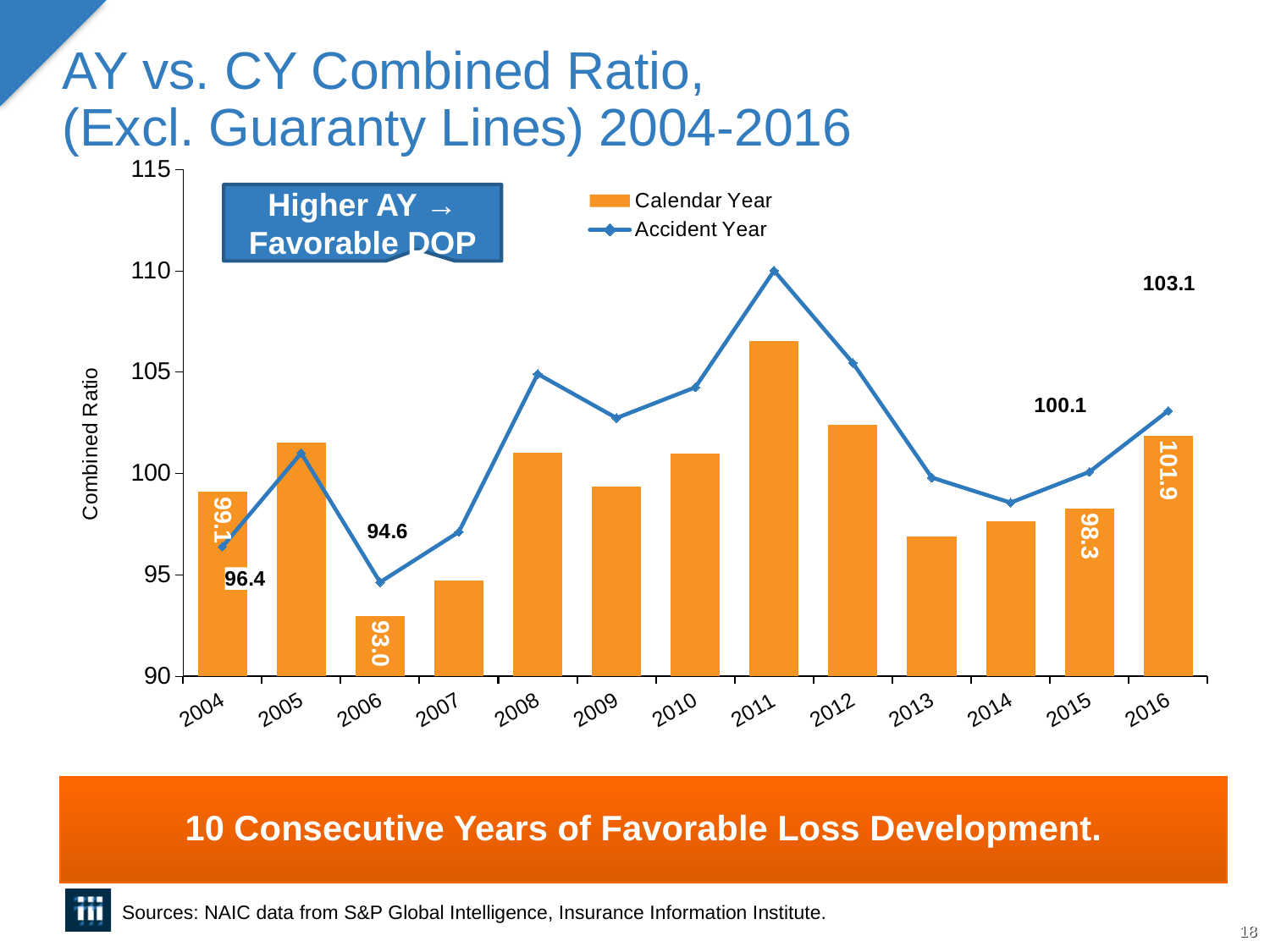
What is the Calendar Year combined ratio for 2004? 99.1 How many series does the legend list? 2 What is the Accident Year combined ratio for 2016? 103.1 How many years are shown on the x axis? 13 What is the Calendar Year combined ratio for 2006? 93.0 Is the Accident Year combined ratio for 2011 greater or less than 105? greater What is the difference between the Accident Year and Calendar Year combined ratios in 2016? 1.2 In which year is the Calendar Year combined ratio lowest? 2006 In which year is the Accident Year combined ratio highest? 2011 What is the Accident Year combined ratio for 2015? 100.1 In 2015, which is larger: the Calendar Year or the Accident Year combined ratio? Accident Year What is the difference between the Calendar Year and Accident Year combined ratios in 2004? 2.7